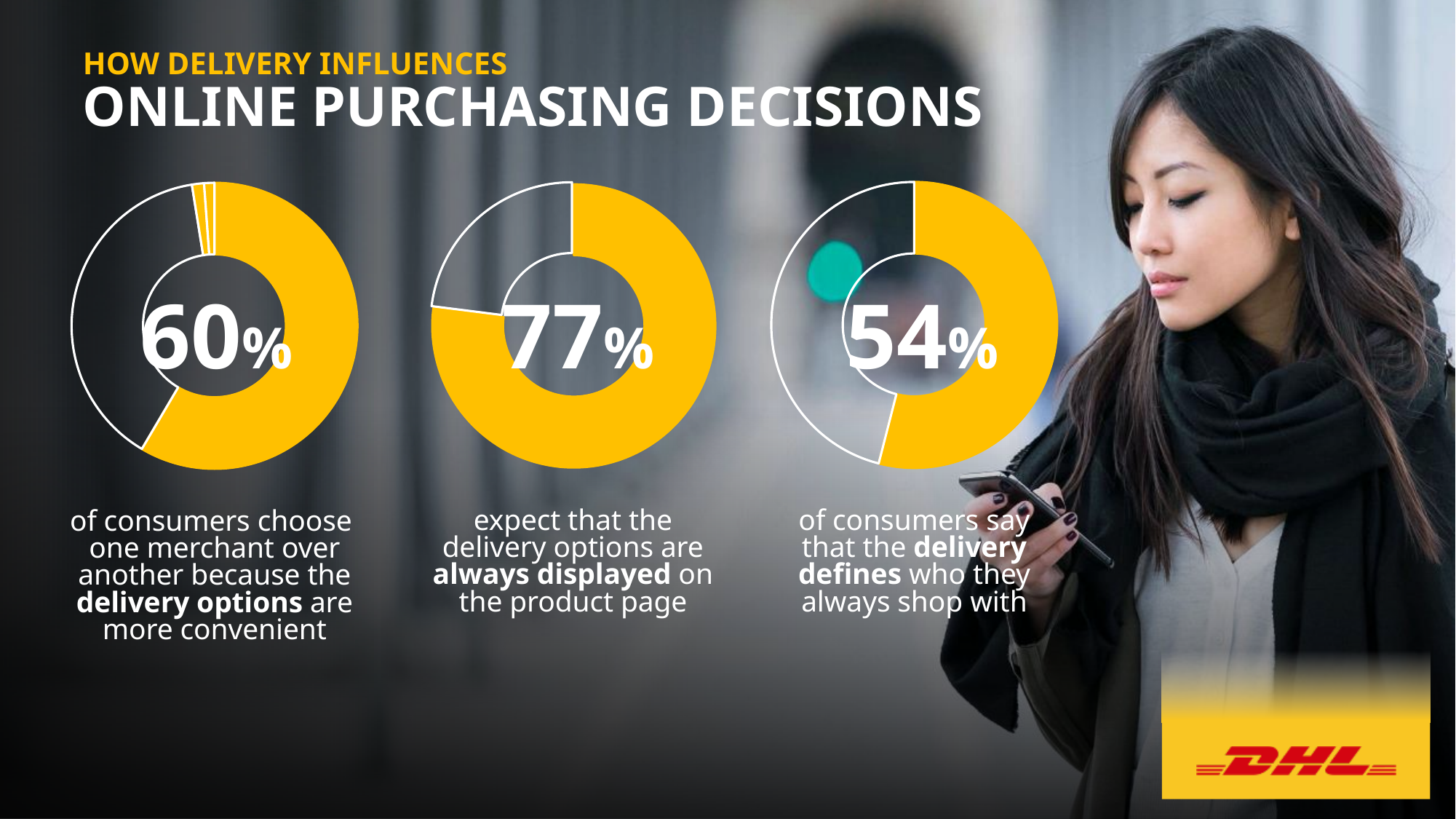
What percentage is shown in the middle donut chart, about consumers expecting delivery options to always be displayed on the product page? 77% Which of the three donut charts shows the lowest percentage? The right chart (54%) What is the difference between the percentage in the middle donut chart and the percentage in the left donut chart? 17 percentage points What percentage is shown in the right donut chart, about consumers saying the delivery defines who they always shop with? 54% What is the difference between the percentage in the middle donut chart and the percentage in the right donut chart? 23 percentage points What kind of charts are used on this slide? Donut (pie) charts What is the title of the slide containing the donut charts? How delivery influences online purchasing decisions Which is larger: the percentage in the left donut chart or the percentage in the right donut chart? The left chart (60%) What colour is used for the highlighted segment in each donut chart? Yellow How many donut charts are shown on the slide? 3 Which of the three donut charts shows the highest percentage? The middle chart (77%) What percentage is shown in the left donut chart, about consumers choosing one merchant over another because the delivery options are more convenient? 60%